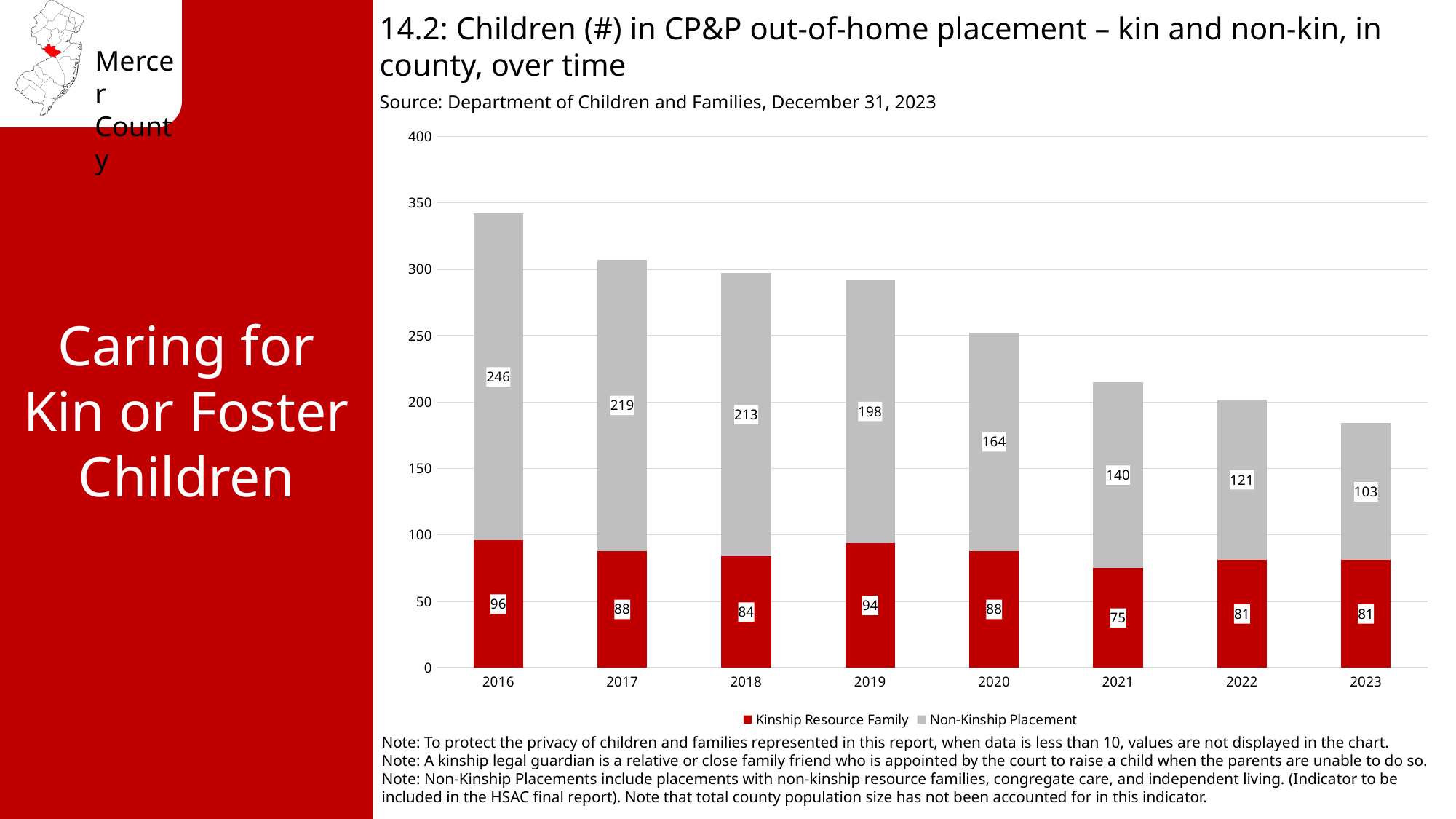
What is the Non-Kinship Placement value for 2016? 246 What is the Kinship Resource Family value for 2021? 75 Is the total height of the 2016 bar greater or less than 300? greater What is the total of the stacked bar for 2022? 202 Which year has the lowest Kinship Resource Family value? 2021 Which is larger, the Kinship Resource Family value for 2019 or for 2020? 2019 How many years are shown on the x axis? 8 How many series does the legend list? 2 What is the Non-Kinship Placement value for 2023? 103 Which year has the highest Non-Kinship Placement value? 2016 What kind of chart is shown on the slide? Stacked bar chart What is the difference between the Non-Kinship Placement values for 2016 and 2023? 143